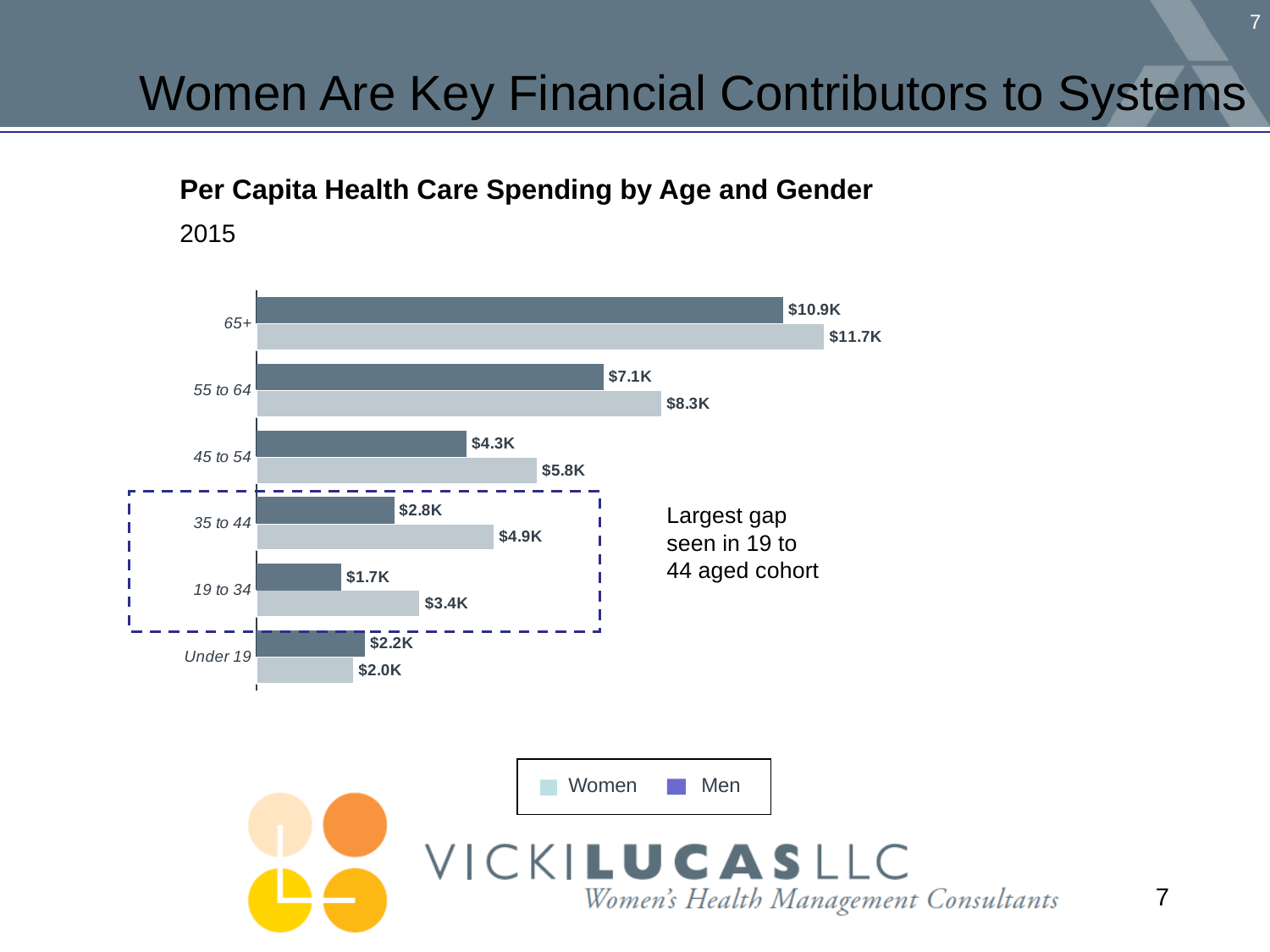
What is the per capita health care spending for men aged 55 to 64? $7.1K Which age group has the lowest per capita health care spending for men? 19 to 34 What kind of chart is shown on the slide? Bar chart How many series does the legend list? 2 In the Under 19 age group, who has higher per capita health care spending, women or men? Men Which age group has the highest per capita health care spending for women? 65+ How many age groups are shown in the chart? 6 What is the per capita health care spending for women aged 35 to 44? $4.9K What year does the chart's data refer to? 2015 What is the per capita health care spending for women aged 65+? $11.7K What is the difference between women's and men's per capita spending in the 35 to 44 age group? $2.1K What is the per capita health care spending for men aged 19 to 34? $1.7K